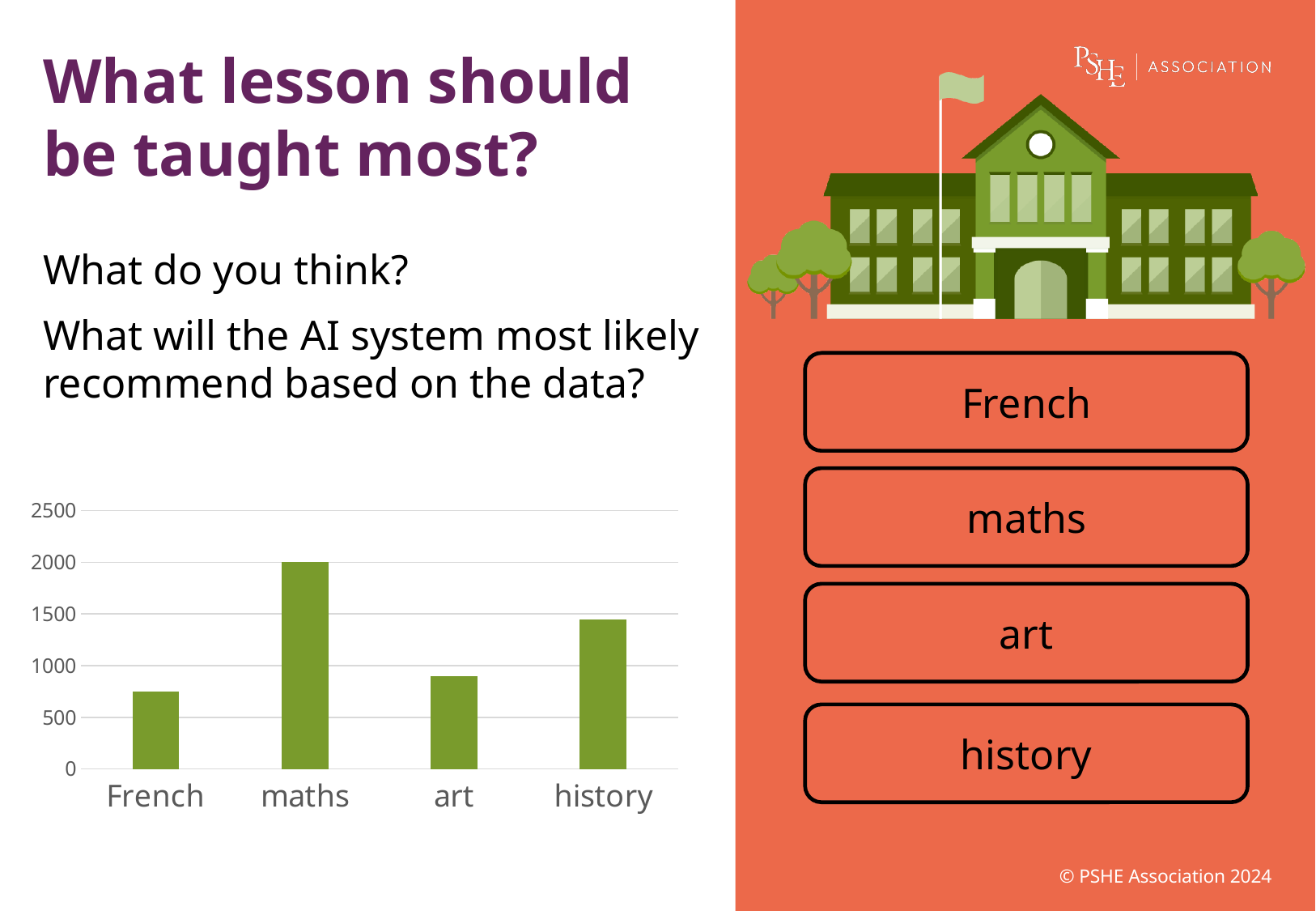
Which has the larger value in the chart, history or art? history Is the value for French greater or less than 1000? less What is the highest value shown on the chart's vertical axis? 2500 Which category has the lowest bar in the chart? French Which has the larger value in the chart, maths or French? maths Which category has the highest bar in the chart? maths Is the value for history greater or less than 1000? greater Is the value for French greater or less than 500? greater How many categories are shown on the x axis of the chart? 4 What type of chart is shown on the slide? bar chart What is the value for maths in the chart? 2000